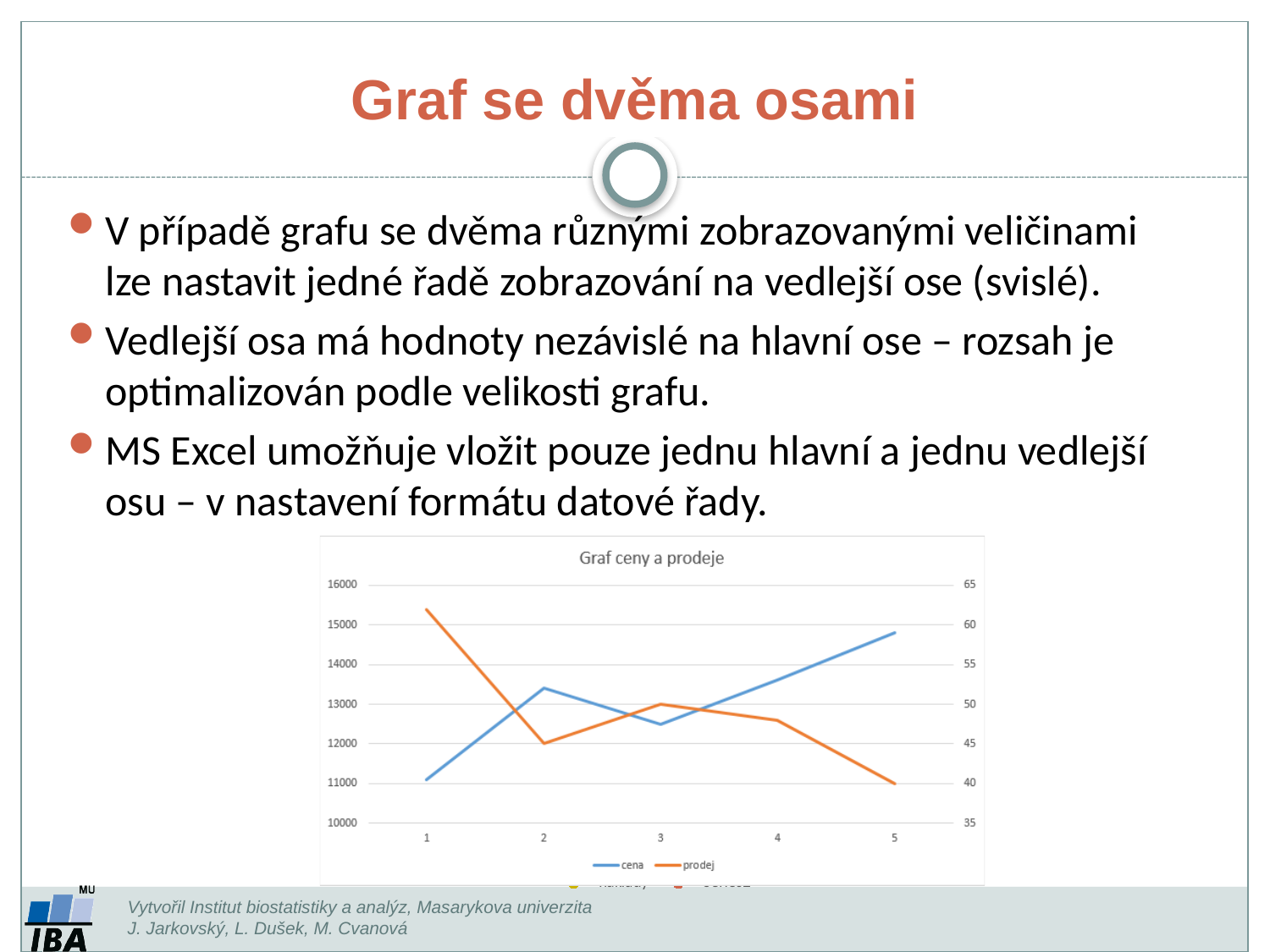
Is the value of cena at category 5 greater or less than 14000 on the left axis? greater What is the title of the chart on the slide? Graf ceny a prodeje At which x-axis category does the cena series have its lowest value? 1 How many points are plotted along the x axis for each series? 5 At category 5, which series is plotted higher on the chart, cena or prodej? cena What kind of chart is shown on the slide? line chart At which x-axis category does the cena series reach its highest value? 5 Is the value of cena at category 1 greater or less than 12000 on the left axis? less At which x-axis category does the prodej series reach its highest value? 1 Does the prodej series overall rise or fall from category 1 to category 5? fall How many series does the chart legend list? 2 At which x-axis category does the prodej series have its lowest value? 5